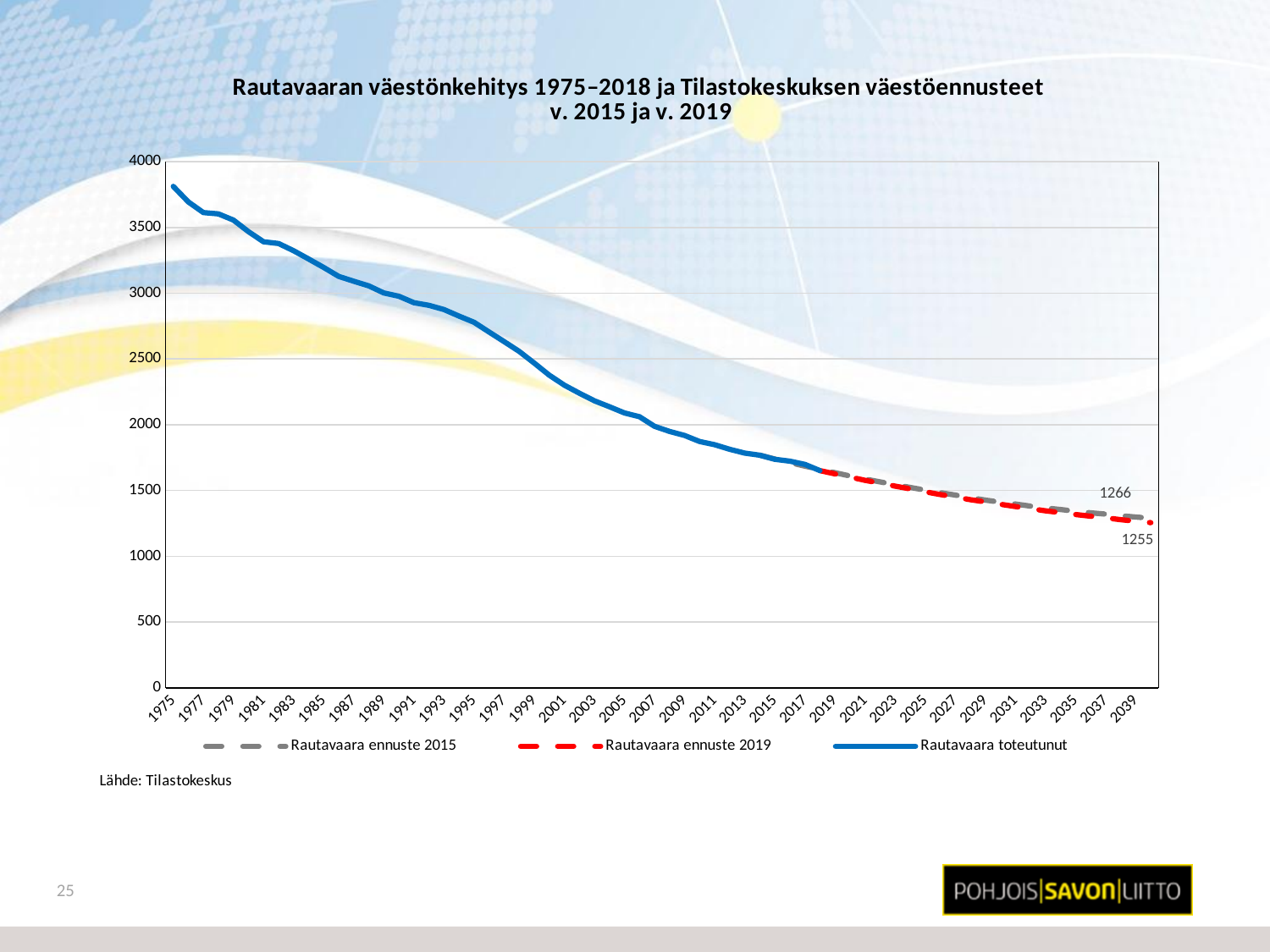
Is the Rautavaara toteutunut value for 1975 greater or less than 3500? greater How many series does the legend list? 3 What is the final labelled value of the Rautavaara ennuste 2019 series? 1255 Is the Rautavaara toteutunut value for 1995 greater or less than 2500? greater Does the Rautavaara toteutunut line rise or fall from 1975 to 2018? Fall What source is cited below the chart? Tilastokeskus Is the Rautavaara toteutunut value for 2017 greater or less than 2000? less What kind of chart is shown on the slide? Line chart In which year is the Rautavaara toteutunut series at its highest? 1975 Which forecast series ends at a higher value, Rautavaara ennuste 2015 or Rautavaara ennuste 2019? Rautavaara ennuste 2015